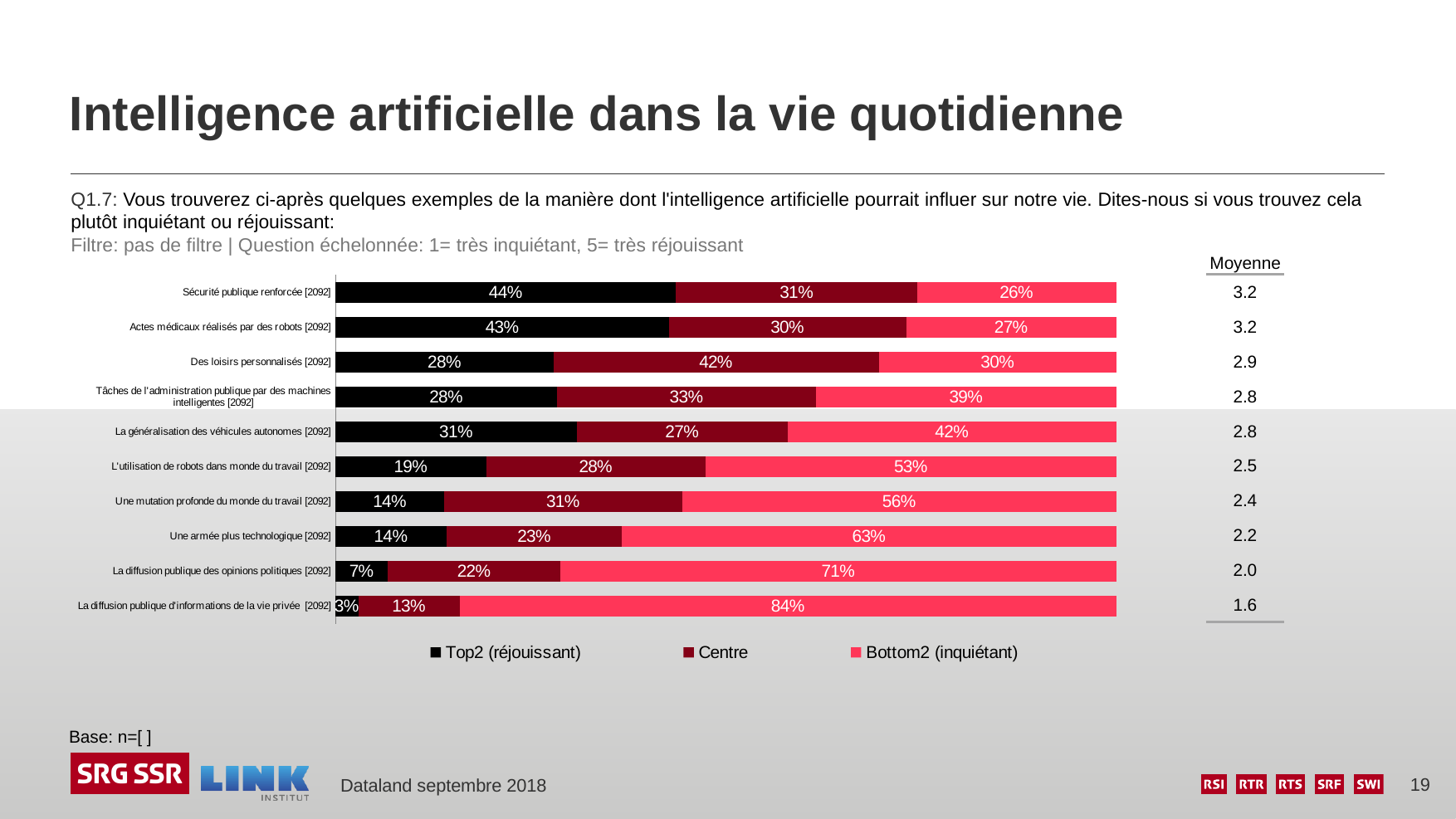
How many series does the legend list? 3 What is the Centre value for "Des loisirs personnalisés"? 42% What kind of chart is shown on the slide? Stacked bar chart Which category has the highest Bottom2 (inquiétant) value? La diffusion publique d'informations de la vie privée What is the Bottom2 (inquiétant) value for "La diffusion publique d'informations de la vie privée"? 84% What is the difference between the Bottom2 (inquiétant) values for "Une armée plus technologique" and "Une mutation profonde du monde du travail"? 7% What is the Moyenne value shown for "La diffusion publique des opinions politiques"? 2.0 Which category has the lowest Top2 (réjouissant) value? La diffusion publique d'informations de la vie privée Which is larger: the Top2 (réjouissant) value for "La généralisation des véhicules autonomes" or for "L'utilisation de robots dans monde du travail"? La généralisation des véhicules autonomes How many categories are shown in the chart? 10 Which series is shown in black in the legend? Top2 (réjouissant) What is the Top2 (réjouissant) value for "Sécurité publique renforcée"? 44%